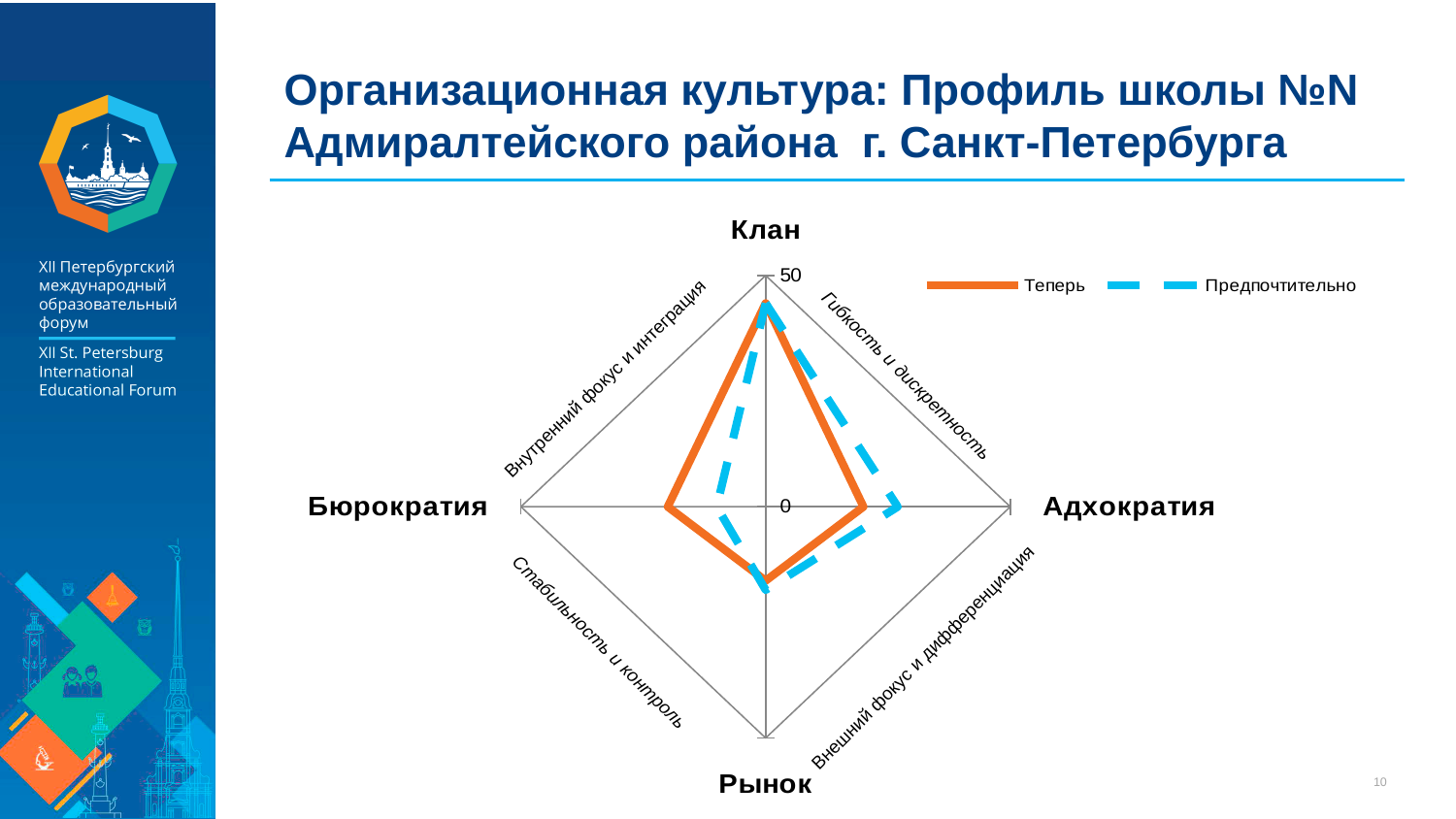
What are the two series named in the legend? Теперь and Предпочтительно Which category has the highest value for the Предпочтительно series? Клан What kind of chart is shown on the slide? radar chart How many axes (categories) does the radar chart have? 4 Is the Теперь value for Клан greater or less than 50? less For Адхократия, which series has the larger value: Теперь or Предпочтительно? Предпочтительно How many series does the chart's legend list? 2 Which series is drawn with a dashed line? Предпочтительно Which category has the lowest value for the Предпочтительно series? Бюрократия For Бюрократия, which series has the larger value: Теперь or Предпочтительно? Теперь For the Предпочтительно series, which is larger: Адхократия or Бюрократия? Адхократия Which category has the highest value for the Теперь series? Клан